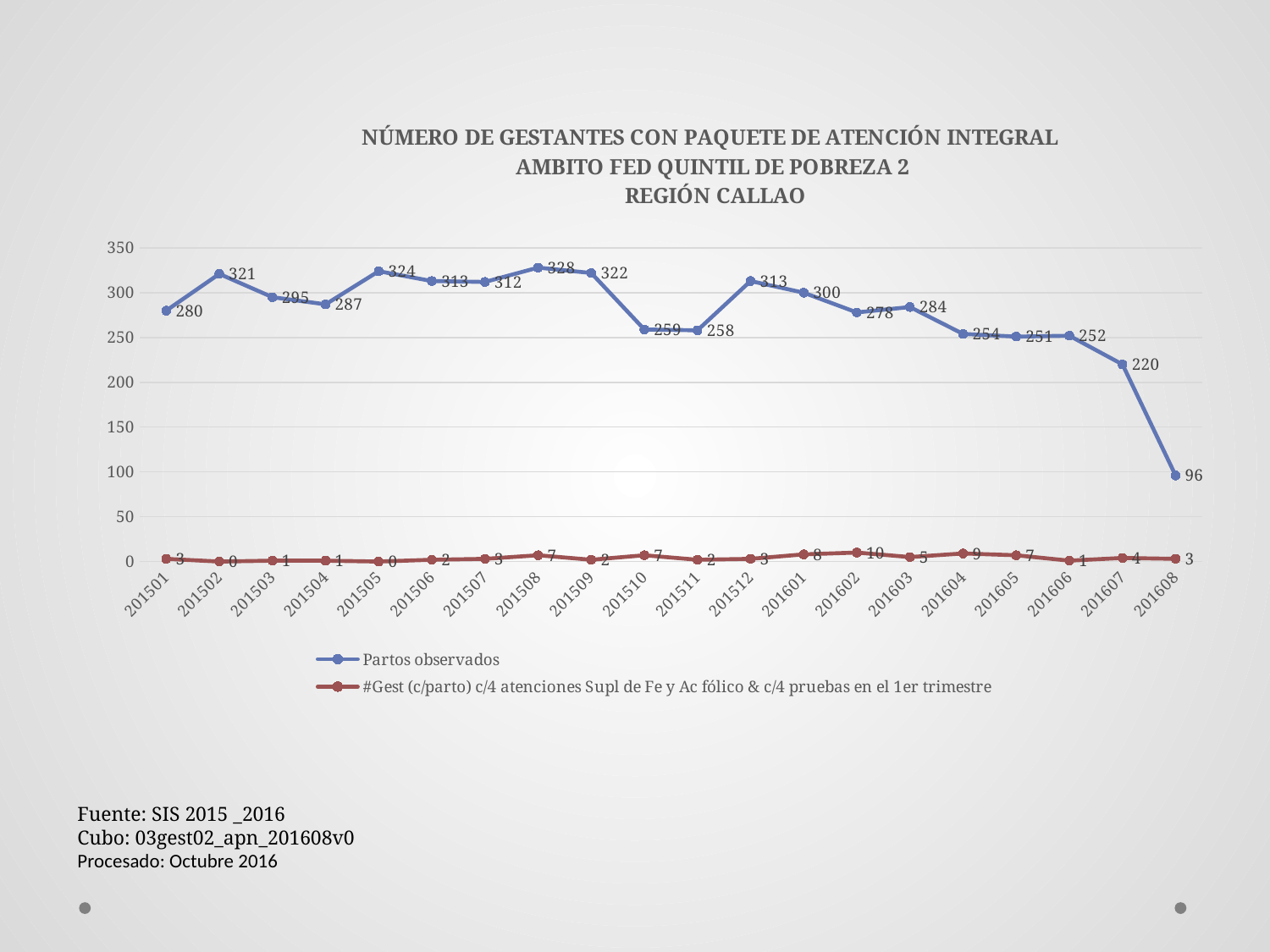
Does Partos observados rise or fall from 201606 to 201608? Fall What is the difference in Partos observados between 201607 and 201608? 124 What kind of chart is shown on the slide? Line chart What is the value of Partos observados for 201508? 328 What is the value of Partos observados for 201601? 300 What is the value of the #Gest (c/parto) series for 201602? 10 In which month is Partos observados highest? 201508 How many months are plotted on the x axis? 20 How many series does the legend list? 2 In which month does the #Gest (c/parto) series reach its highest value? 201602 In which month is Partos observados lowest? 201608 Which month has a higher value of Partos observados, 201510 or 201512? 201512